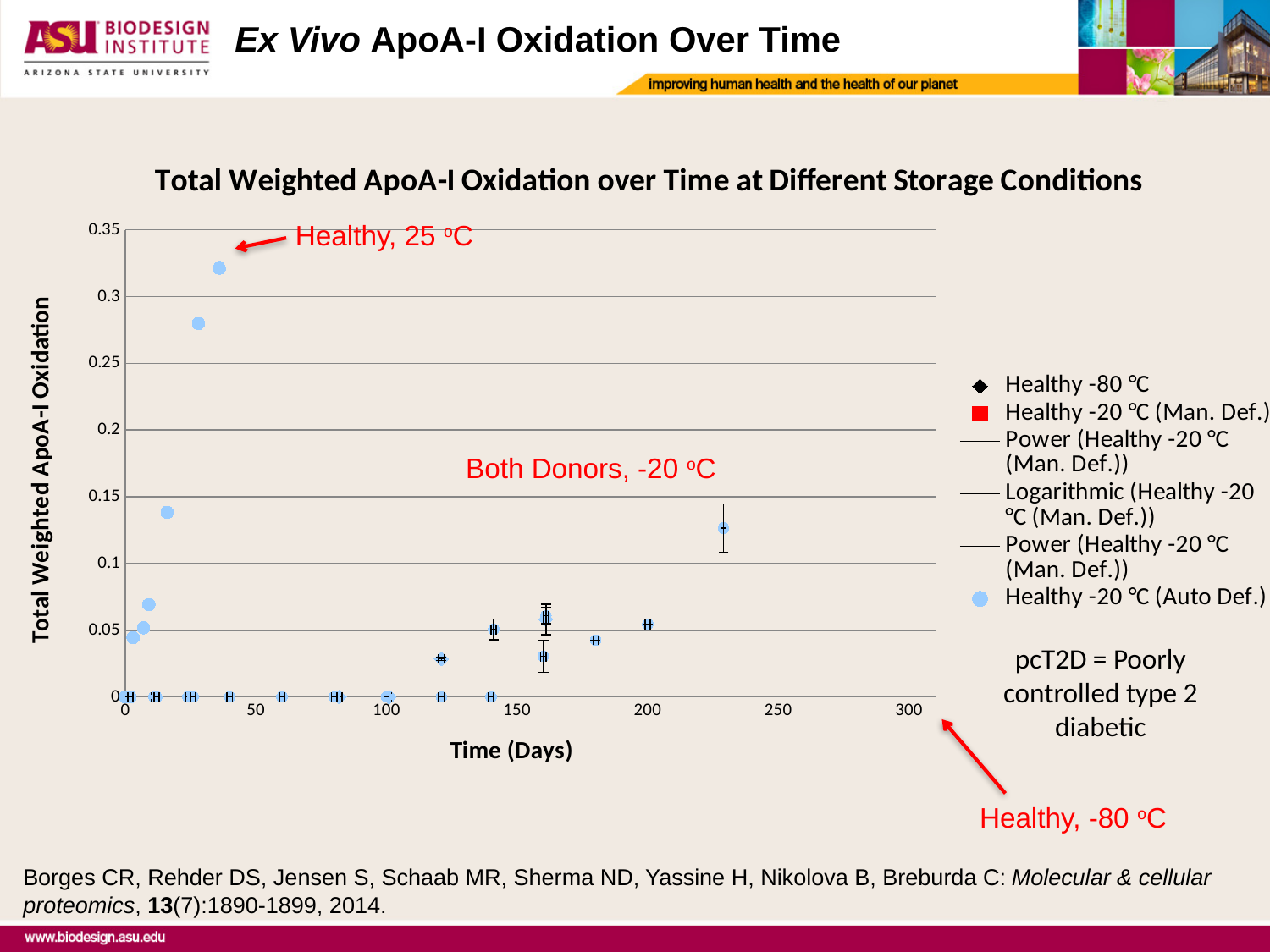
Is the value of the plotted point near 230 days greater or less than 0.15? less What is the highest value shown on the y axis of the chart? 0.35 Is the highest plotted point on the chart (the Healthy, 25 °C point near 35 days) greater or less than 0.3? greater What kind of chart is shown on the slide? Scatter chart Is the value of the plotted point near 230 days greater or less than 0.1? greater What is the highest value shown on the x axis of the chart? 300 Do the light-blue Healthy, 25 °C points rise or fall as time increases from 0 to about 35 days? Rise Which is larger: the value of the point near 35 days or the value of the point near 230 days? The point near 35 days How many entries does the chart's legend list? 6 What is the label of the x axis of the chart? Time (Days) What is the title of the chart? Total Weighted ApoA-I Oxidation over Time at Different Storage Conditions